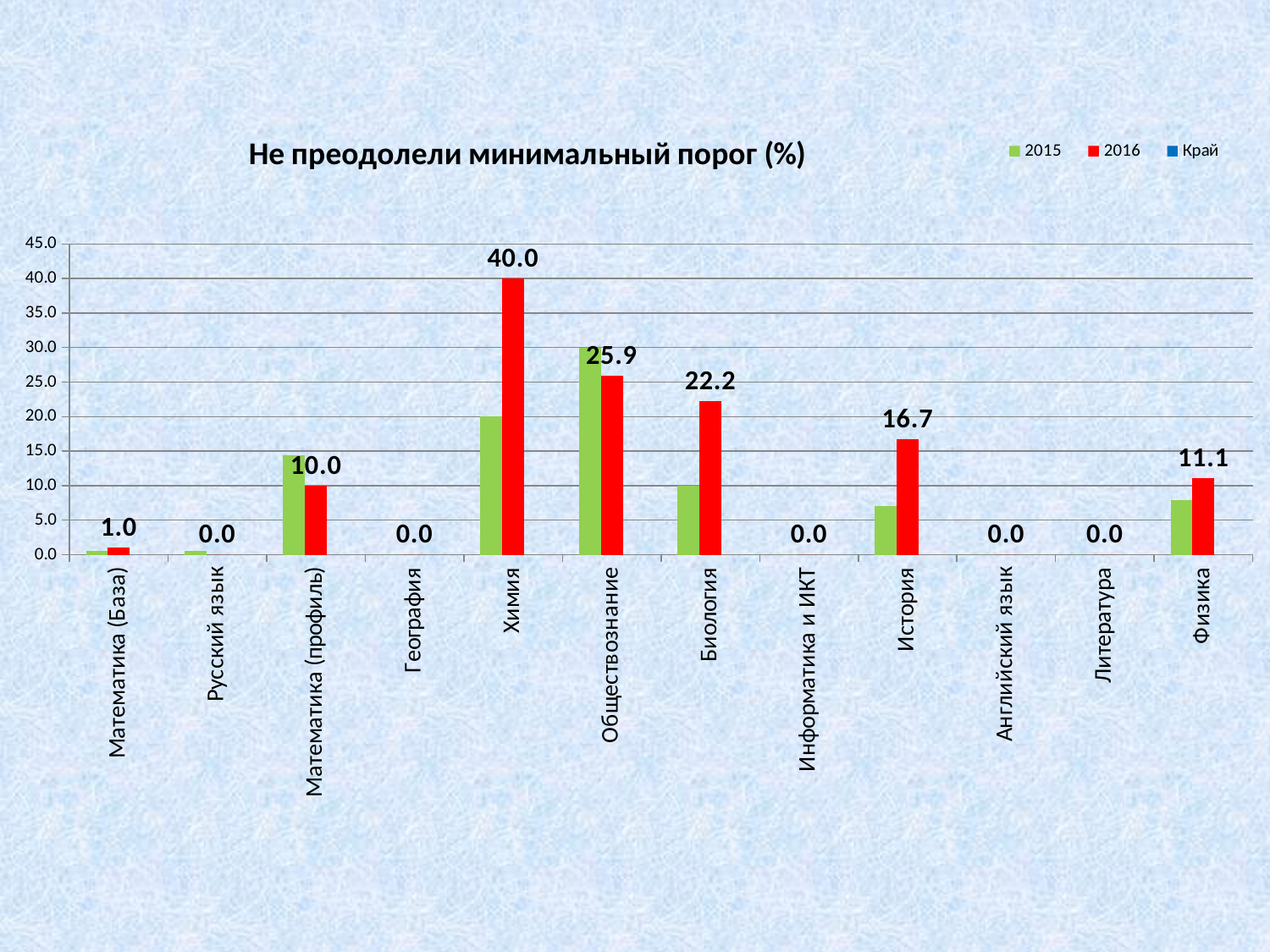
What is the difference between the 2016 values for Химия and Обществознание? 14.1 What is the 2016 value for История? 16.7 What is the 2016 value for Химия? 40.0 Which is larger, the 2016 value for Биология or the 2016 value for История? Биология Is the 2015 value for Обществознание greater or less than 25.0? greater What is the 2016 value for Биология? 22.2 What is the 2016 value for Физика? 11.1 How many categories are shown on the x axis? 12 What is the title of the chart? Не преодолели минимальный порог (%) Which category has the highest 2016 value? Химия How many series does the legend list? 3 Is the 2015 value for История greater or less than 10.0? less